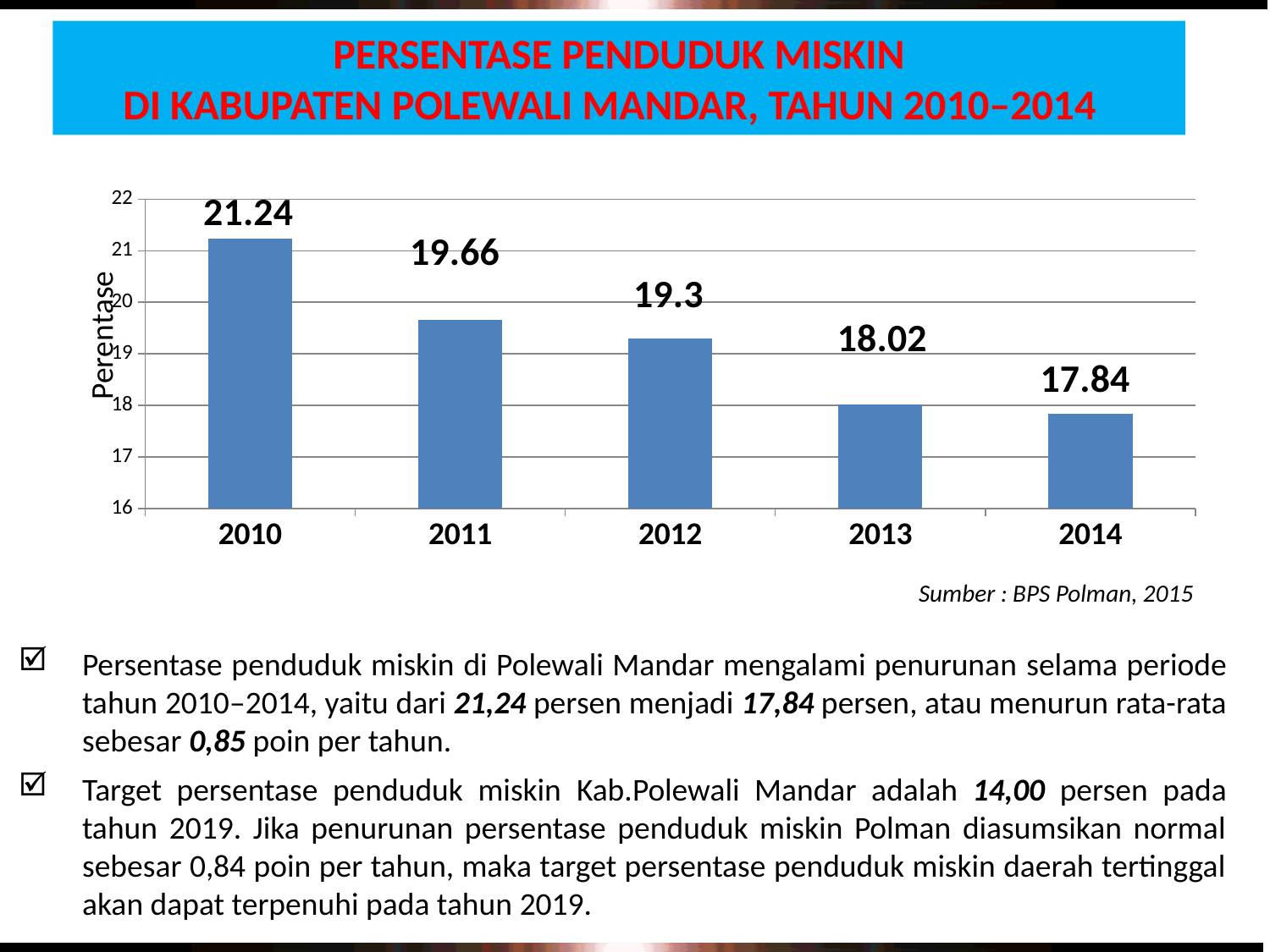
What is the value for 2010? 21.24 Which is larger, the value for 2011 or the value for 2013? 2011 Which year has the lowest value? 2014 Which year has the highest value? 2010 How many years are shown on the x axis? 5 What is the value for 2014? 17.84 What is the difference between the values for 2010 and 2014? 3.4 What is the value for 2012? 19.3 What kind of chart is shown? bar chart What is the difference between the values for 2011 and 2012? 0.36 Do the values rise or fall from 2010 to 2014? fall Is the value for 2013 greater or less than 19? less